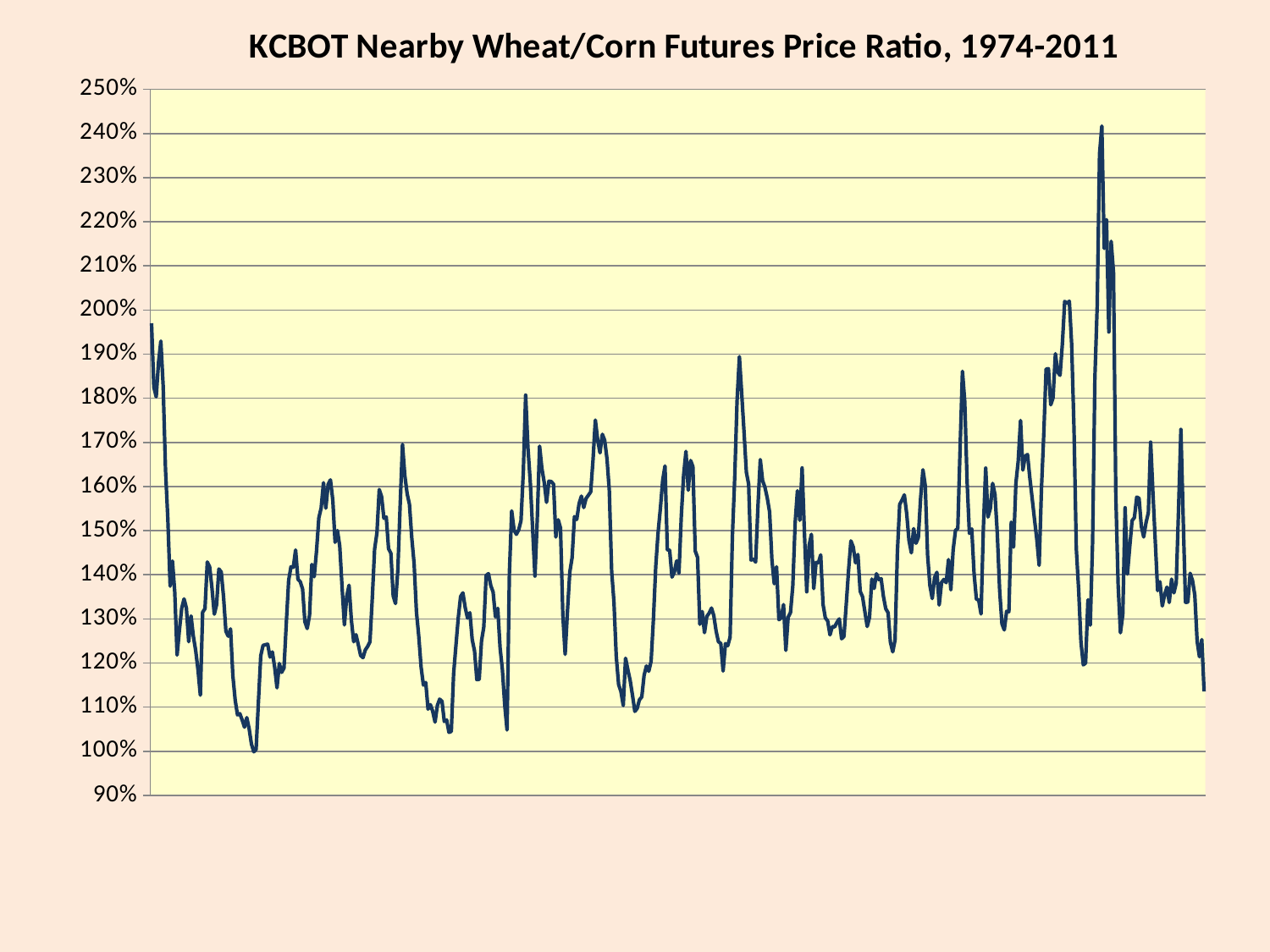
What kind of chart is shown on the slide? line chart Is the final value at the right end of the line greater or less than 120%? less Is the lowest point of the line greater or less than 110%? less Is the highest peak of the line greater or less than 230%? greater What is the title of the chart? KCBOT Nearby Wheat/Corn Futures Price Ratio, 1974-2011 What is the highest value labelled on the vertical axis of the chart? 250% How many lines are plotted on the chart? 1